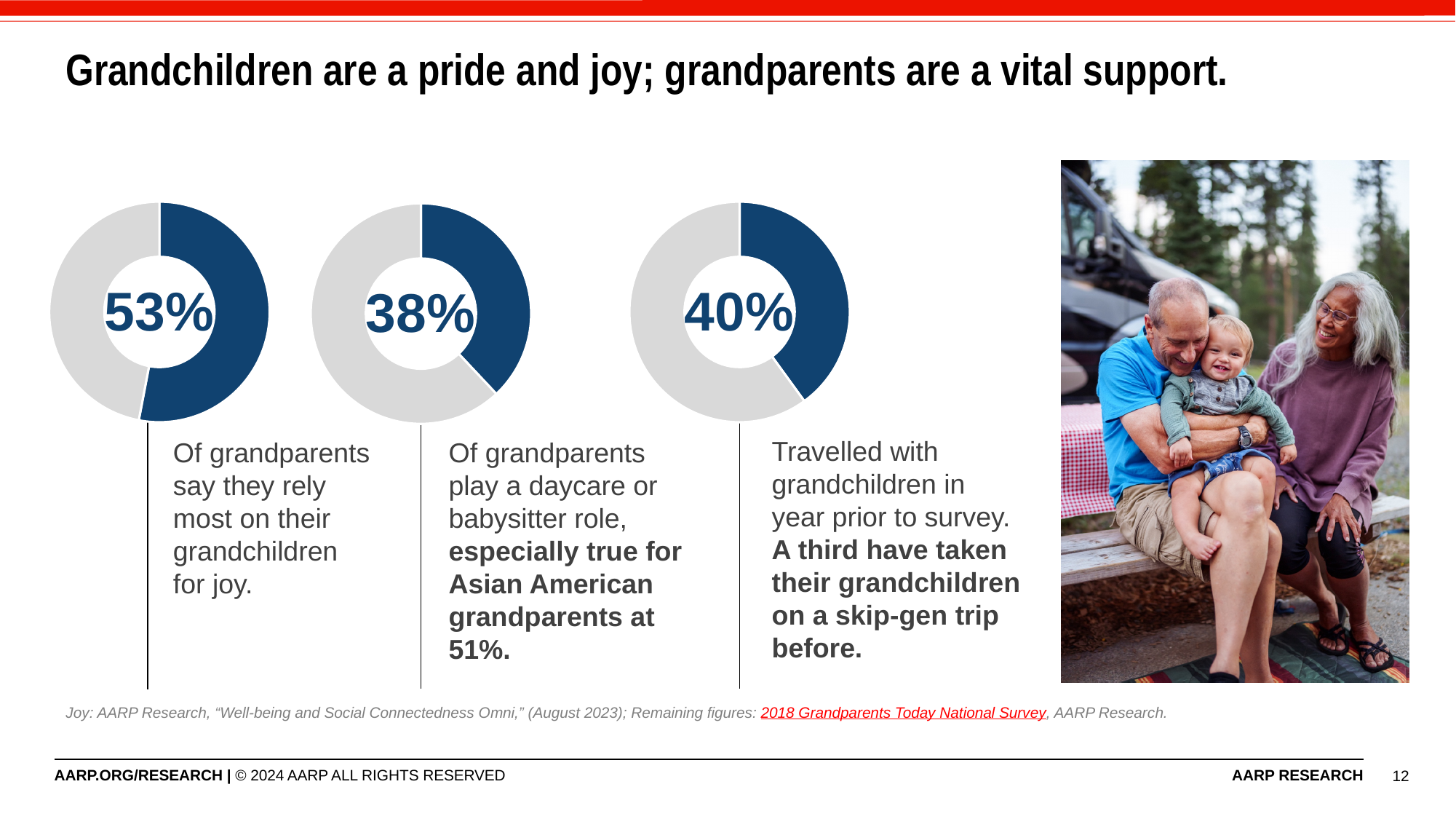
Which of the three donut charts shows the highest value? The left chart (53%) How many donut charts are on the slide? 3 What value is shown in the middle donut chart? 38% What is the difference between the value in the left donut chart and the value in the middle donut chart? 15 percentage points Is the value in the right donut chart larger or smaller than the value in the middle donut chart? Larger What value is shown in the left donut chart? 53% What percentage of grandparents say they rely most on their grandchildren for joy, according to the left donut chart? 53% According to the right donut chart, what percentage travelled with grandchildren in the year prior to the survey? 40% What type of chart is used to display the three percentages on the slide? Donut (pie) chart What value is shown in the right donut chart? 40% Which of the three donut charts shows the lowest value? The middle chart (38%) According to the middle donut chart, what percentage of grandparents play a daycare or babysitter role? 38%